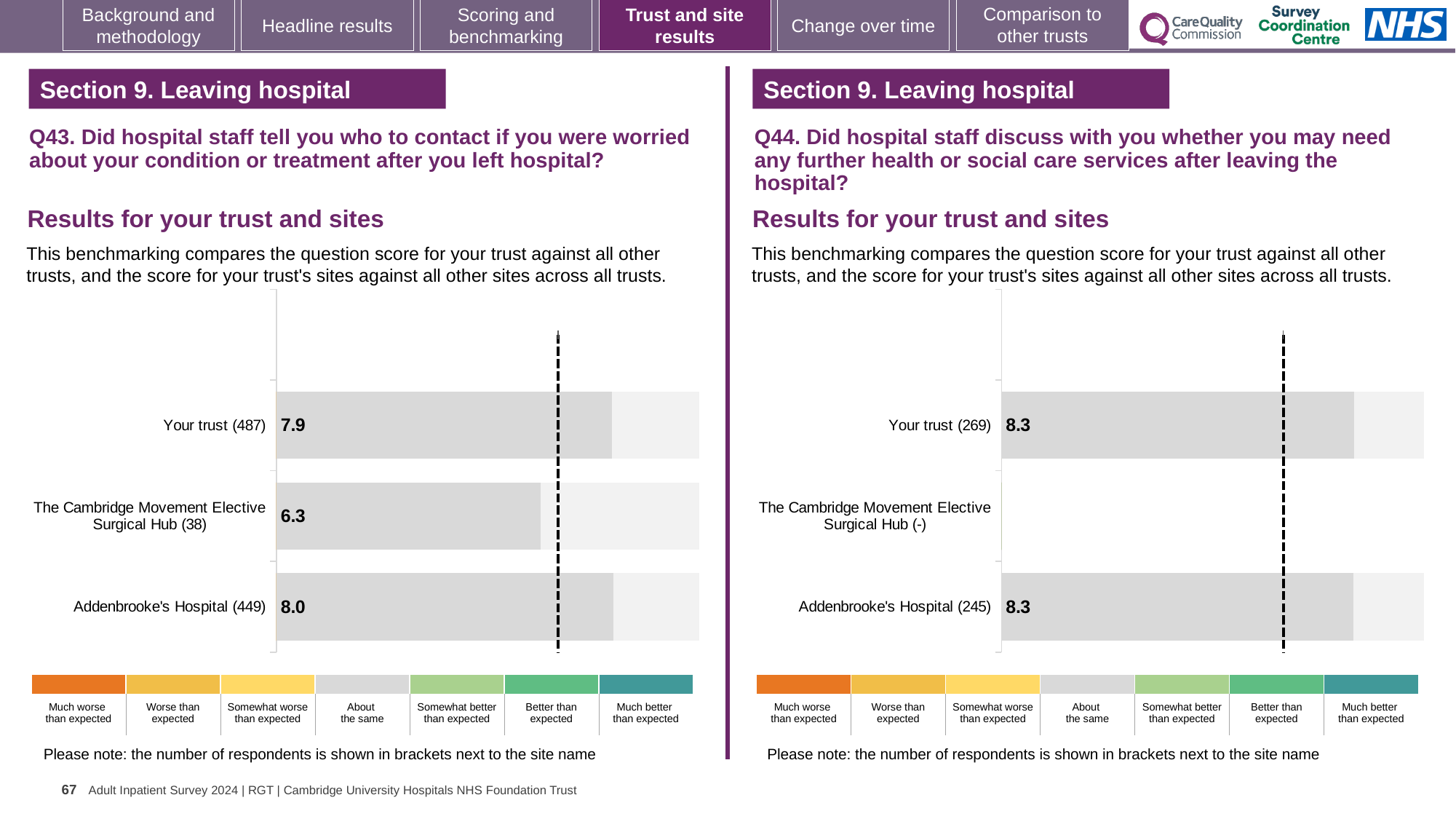
How many site or trust rows are listed in the Q44 chart on the right? 3 What kind of chart is used in the Q43 chart on the left? Bar chart In the Q43 chart on the left, which site or trust has the lowest score? The Cambridge Movement Elective Surgical Hub In the Q43 chart on the left, which site or trust has the highest score? Addenbrooke's Hospital In the Q44 chart on the right, what is the score for Your trust? 8.3 In the Q44 chart on the right, how many respondents are shown in brackets for Addenbrooke's Hospital? 245 In the Q43 chart on the left, what is the score for Addenbrooke's Hospital? 8.0 In the Q43 chart on the left, how many respondents are shown in brackets for Your trust? 487 In the Q44 chart on the right, what is the score for Addenbrooke's Hospital? 8.3 In the Q43 chart on the left, what is the score for The Cambridge Movement Elective Surgical Hub? 6.3 In the Q43 chart on the left, what is the difference between the scores for Addenbrooke's Hospital and The Cambridge Movement Elective Surgical Hub? 1.7 In the Q43 chart on the left, what is the score for Your trust? 7.9